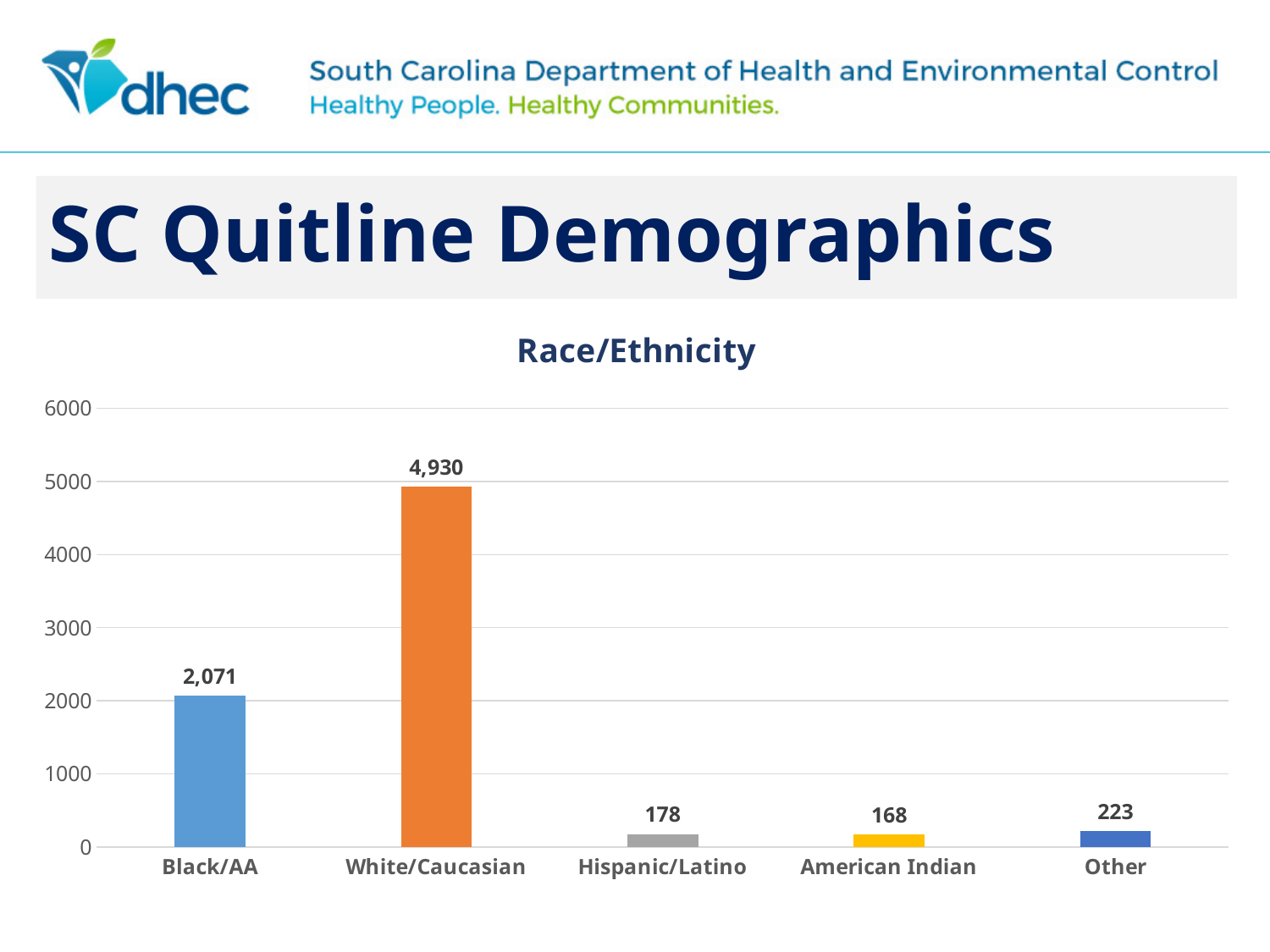
What kind of chart is shown on the slide? bar chart Is the value for Black/AA greater or less than 2000? greater What is the value for Other? 223 Which is larger, the value for Other or the value for Hispanic/Latino? Other What is the value for American Indian? 168 What is the value for Black/AA? 2,071 Which category has the lowest value? American Indian How many categories are shown on the x axis? 5 What is the value for Hispanic/Latino? 178 What is the difference between the values for White/Caucasian and Black/AA? 2,859 What is the value for White/Caucasian? 4,930 Which category has the highest value? White/Caucasian